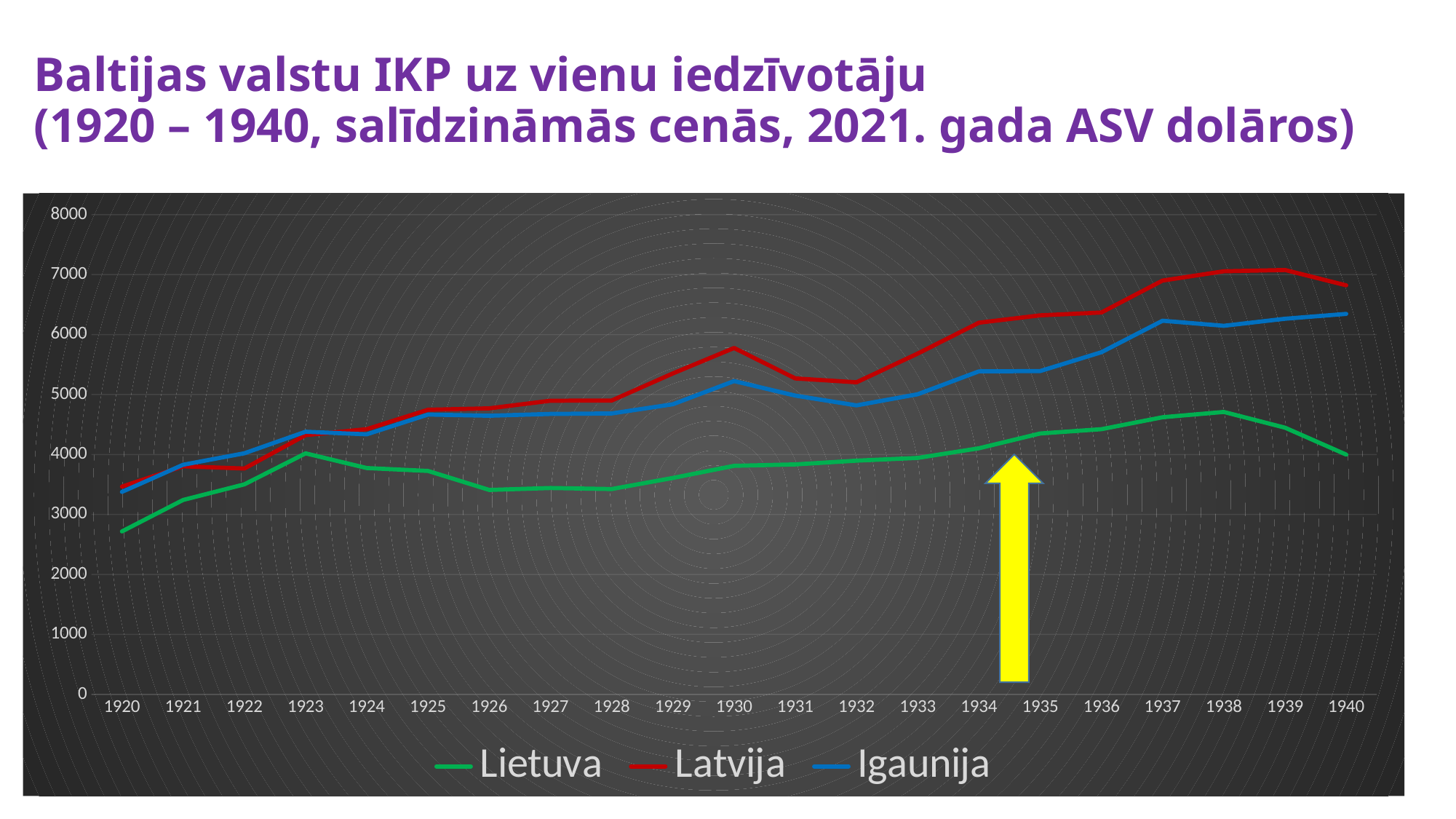
Which series has the lowest value in 1920? Lietuva Does the Lietuva line rise or fall between 1938 and 1940? fall In 1930, which is larger: the value for Igaunija or the value for Lietuva? Igaunija How many series does the legend list? 3 Which series has the highest value in 1940? Latvija Which colour is used for the Latvija series? red What kind of chart is shown on the slide? line chart How many years are shown along the x axis? 21 Is the value for Igaunija in 1940 greater or less than 6000? greater Is the value for Latvija in 1930 greater or less than 5000? greater Is the value for Igaunija in 1932 greater or less than 5000? less